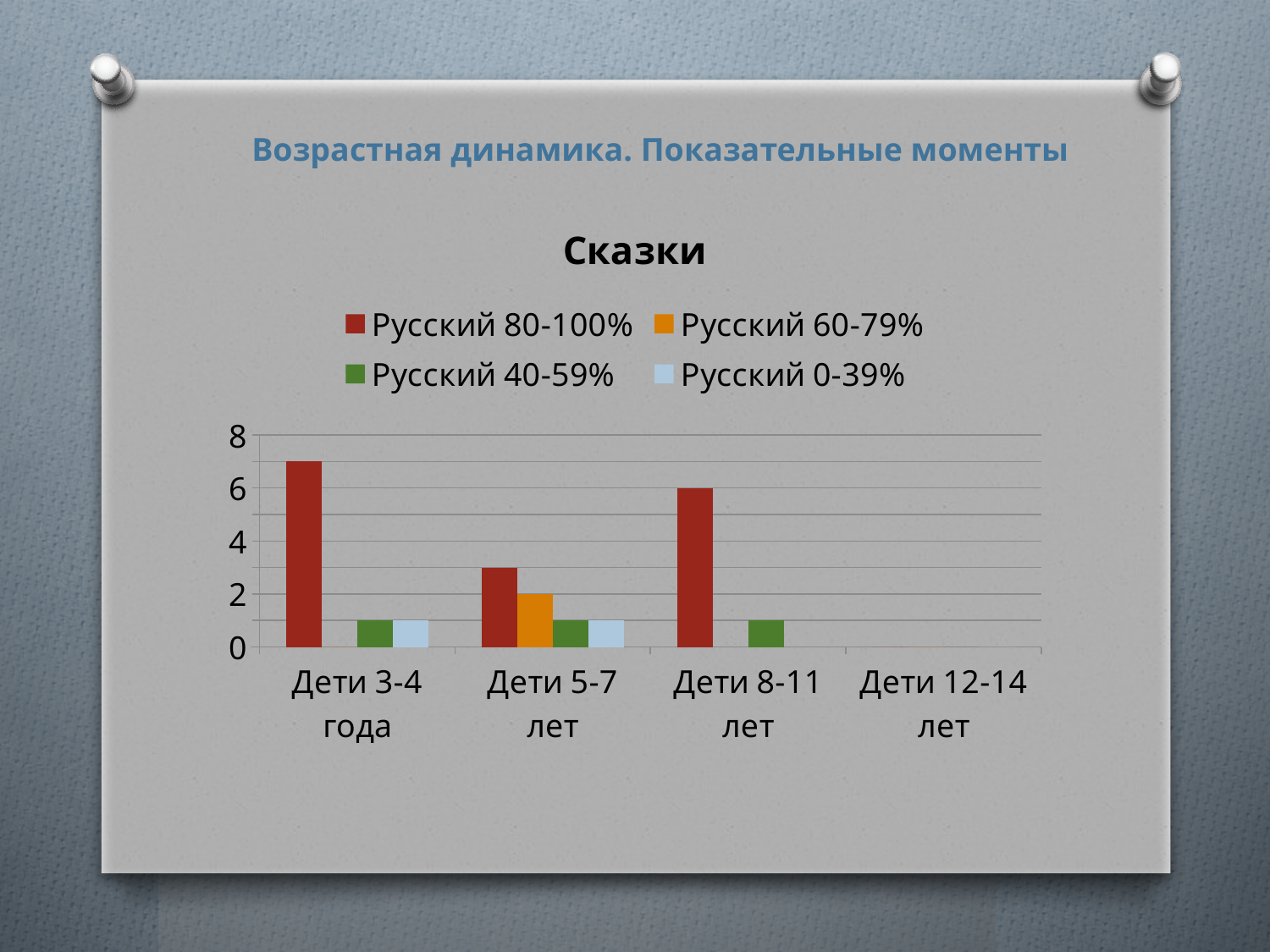
Is the value of Русский 80-100% for Дети 5-7 лет greater or less than 4? less How many series does the legend of the chart list? 4 What is the title of the chart? Сказки How many age categories are shown on the x axis of the chart? 4 For Дети 5-7 лет, which series is larger: Русский 80-100% or Русский 60-79%? Русский 80-100% Which is larger for Русский 80-100%: Дети 3-4 года or Дети 8-11 лет? Дети 3-4 года Which age category has the highest value for Русский 80-100%? Дети 3-4 года What is the value of Русский 60-79% for Дети 5-7 лет? 2 Is the value of Русский 80-100% for Дети 3-4 года greater or less than 6? greater Is the value of Русский 40-59% for Дети 5-7 лет greater or less than 2? less What kind of chart is shown on the slide? bar chart What is the value of Русский 80-100% for Дети 8-11 лет? 6